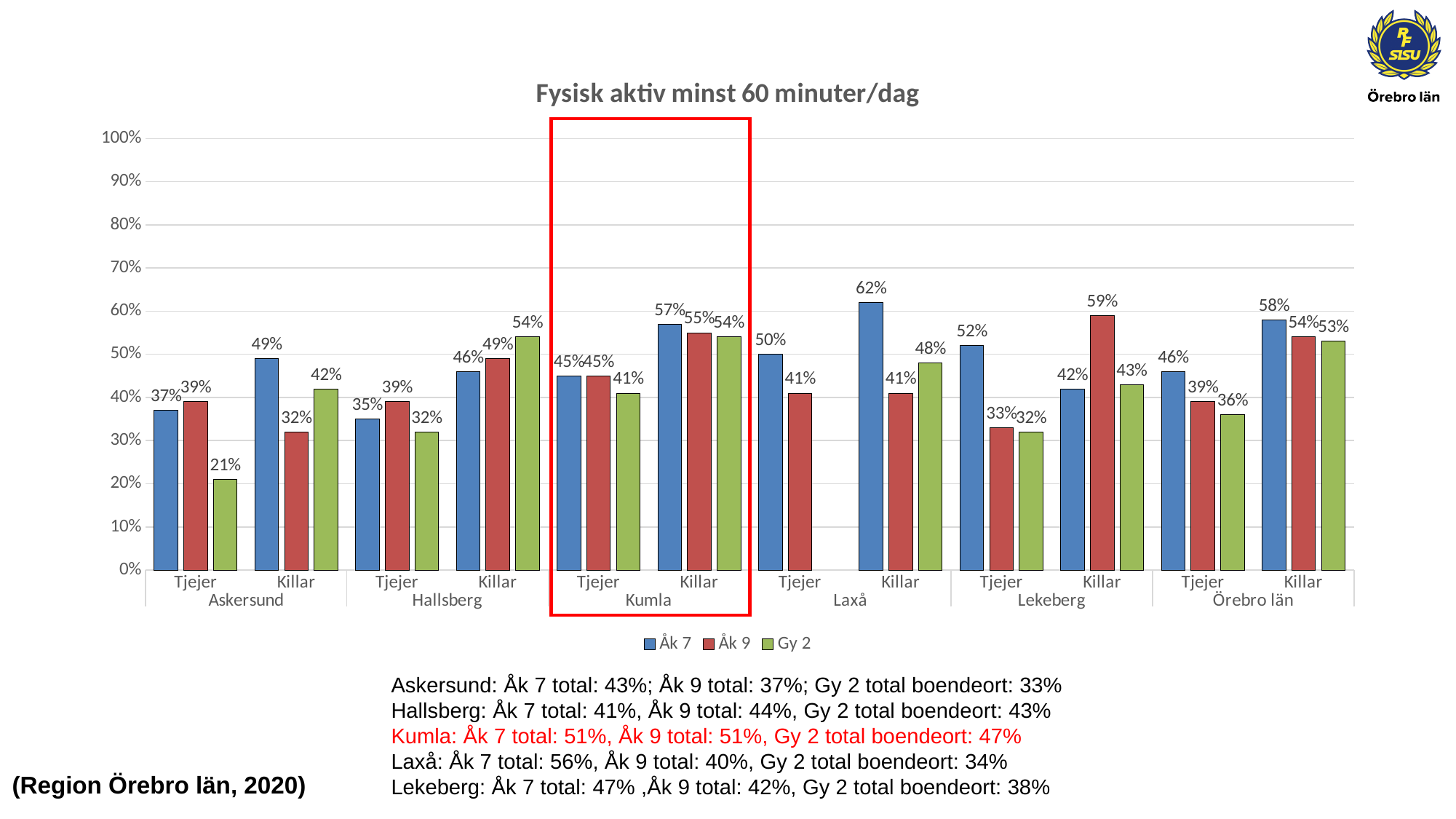
What is the Åk 7 value for Tjejer in Kumla? 45% What is the Åk 9 value for Killar in Lekeberg? 59% What is the Gy 2 value for Tjejer in Askersund? 21% How many series does the legend list? 3 What is the Åk 7 value for Killar in Laxå? 62% Which municipality and group has the highest Åk 7 value? Laxå Killar Which is larger for Killar in Hallsberg: the Åk 7 value or the Gy 2 value? Gy 2 What is the difference between the Åk 7 values for Killar and Tjejer in Örebro län? 12% Which group has the lowest Gy 2 value? Askersund Tjejer How many series names are listed in the legend, and what are they? 3: Åk 7, Åk 9, Gy 2 What is the title of the chart? Fysisk aktiv minst 60 minuter/dag What kind of chart is shown on the slide? Bar chart